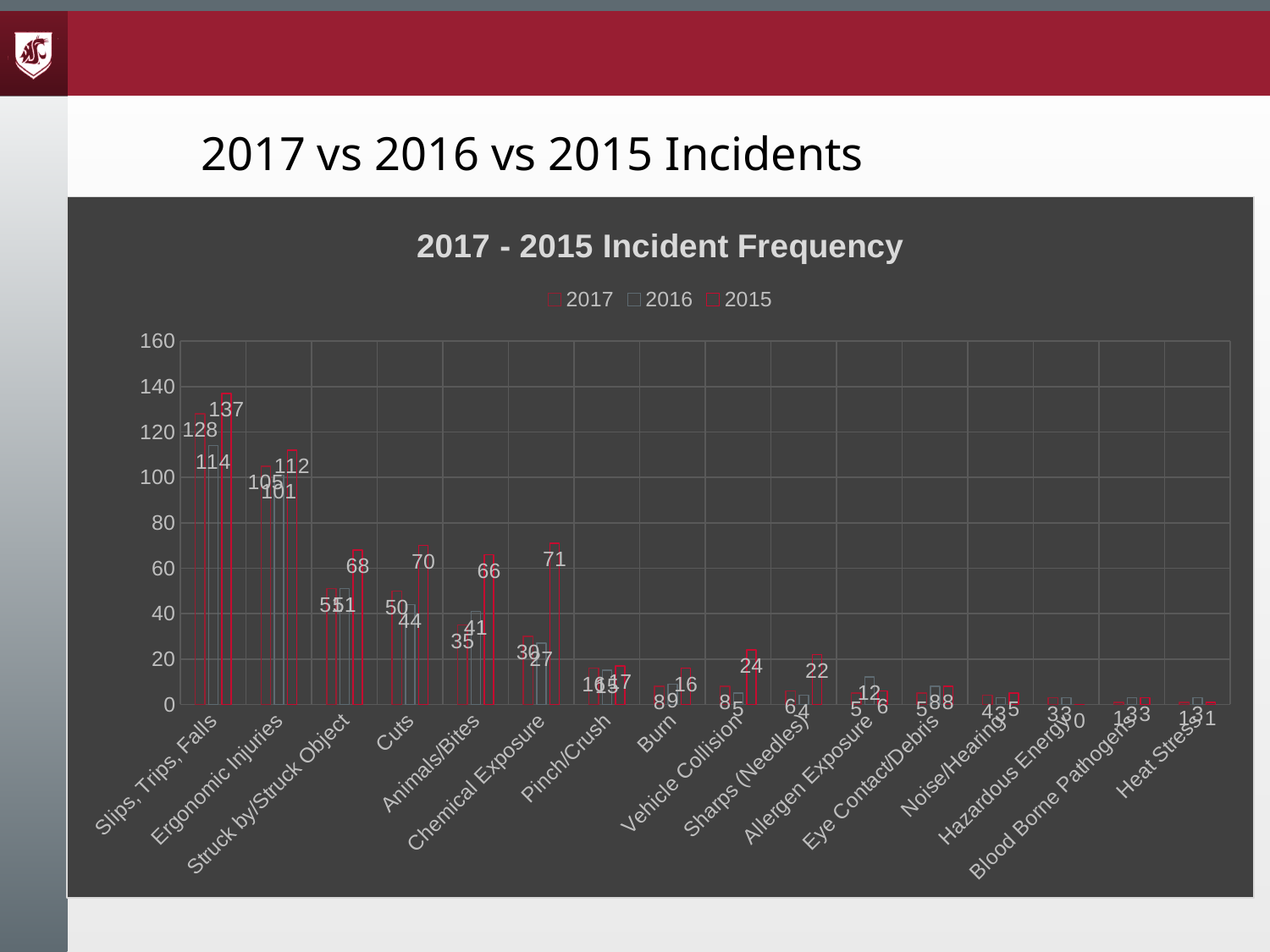
How many incident categories are shown on the x axis? 16 How many series does the legend list? 3 What is the difference between the 2015 and 2017 values for Slips, Trips, Falls? 9 What is the 2015 value for Cuts? 70 What is the 2015 value for Slips, Trips, Falls? 137 Which is larger for 2015: Vehicle Collision or Sharps (Needles)? Vehicle Collision Which category has the highest incident count across all three years? Slips, Trips, Falls What is the title of the chart? 2017 - 2015 Incident Frequency What is the 2015 value for Chemical Exposure? 71 What is the 2016 value for Slips, Trips, Falls? 114 What kind of chart is shown? bar chart What is the 2017 value for Slips, Trips, Falls? 128